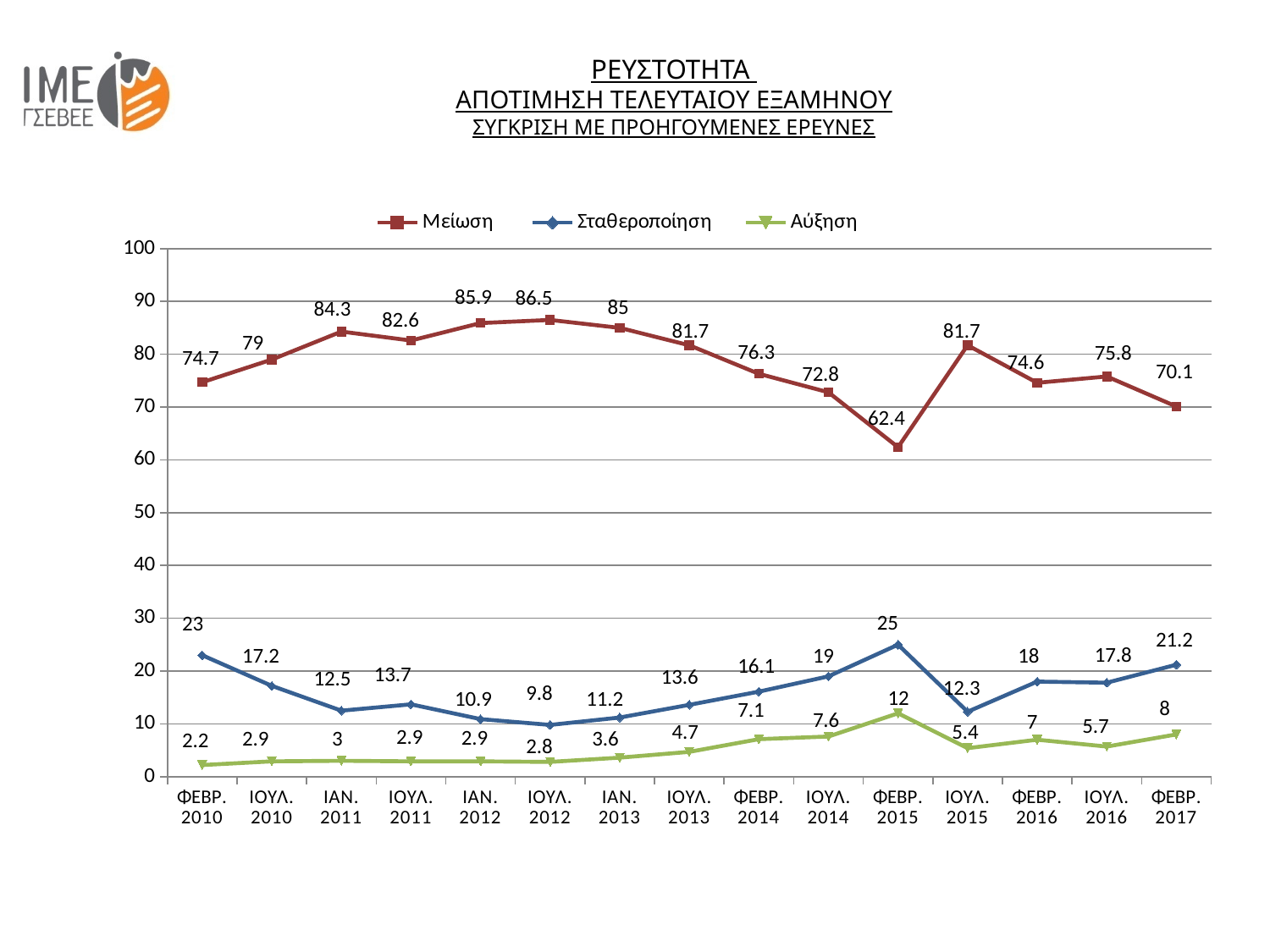
Which series is drawn in green? Αύξηση What is the value of Σταθεροποίηση for ΦΕΒΡ. 2017? 21.2 How many series does the legend list? 3 What type of chart is shown on the slide? line chart How many time points are plotted along the x axis? 15 At which time point is Μείωση lowest? ΦΕΒΡ. 2015 What is the difference between the Μείωση values for ΙΟΥΛ. 2015 and ΦΕΒΡ. 2015? 19.3 Which is larger, the Σταθεροποίηση value for ΦΕΒΡ. 2010 or for ΙΟΥΛ. 2010? ΦΕΒΡ. 2010 What is the value of Μείωση for ΙΟΥΛ. 2012? 86.5 At which time point is Σταθεροποίηση highest? ΦΕΒΡ. 2015 What is the value of Αύξηση for ΦΕΒΡ. 2015? 12 Does the Μείωση series rise or fall from ΦΕΒΡ. 2010 to ΙΟΥΛ. 2012? rise